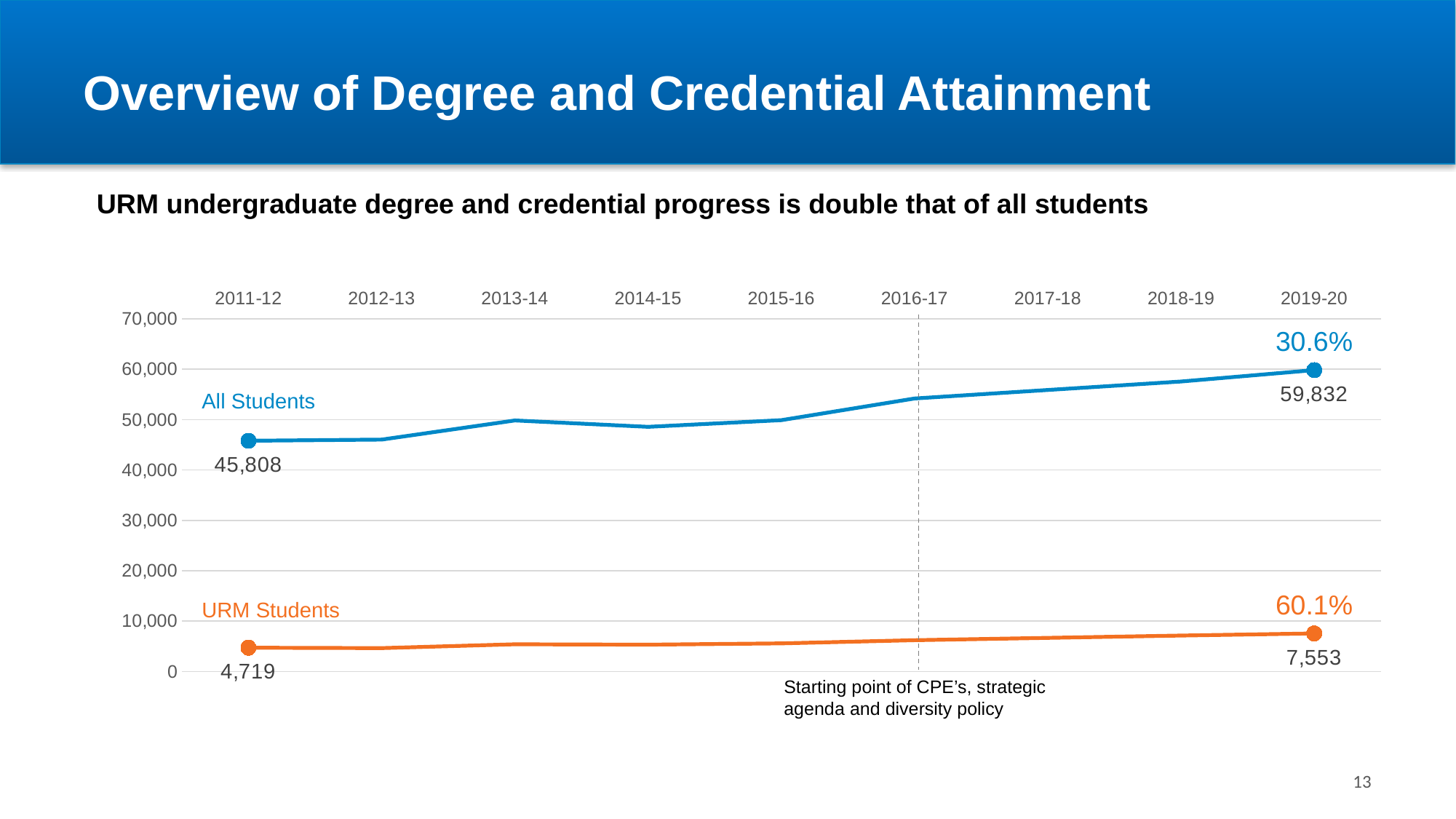
How many academic years are shown on the x axis? 9 What is the value for All Students in 2019-20? 59,832 What type of chart is shown on the slide? line chart Does the URM Students line rise or fall from 2011-12 to 2019-20? rise Is the value for All Students in 2016-17 greater or less than 50,000? greater By how much did the URM Students value increase from 2011-12 to 2019-20? 2,834 By how much did the All Students value increase from 2011-12 to 2019-20? 14,024 What is the value for All Students in 2011-12? 45,808 What percentage growth is labelled for the All Students line? 30.6% What is the value for URM Students in 2019-20? 7,553 What is the value for URM Students in 2011-12? 4,719 What percentage growth is labelled for the URM Students line? 60.1%